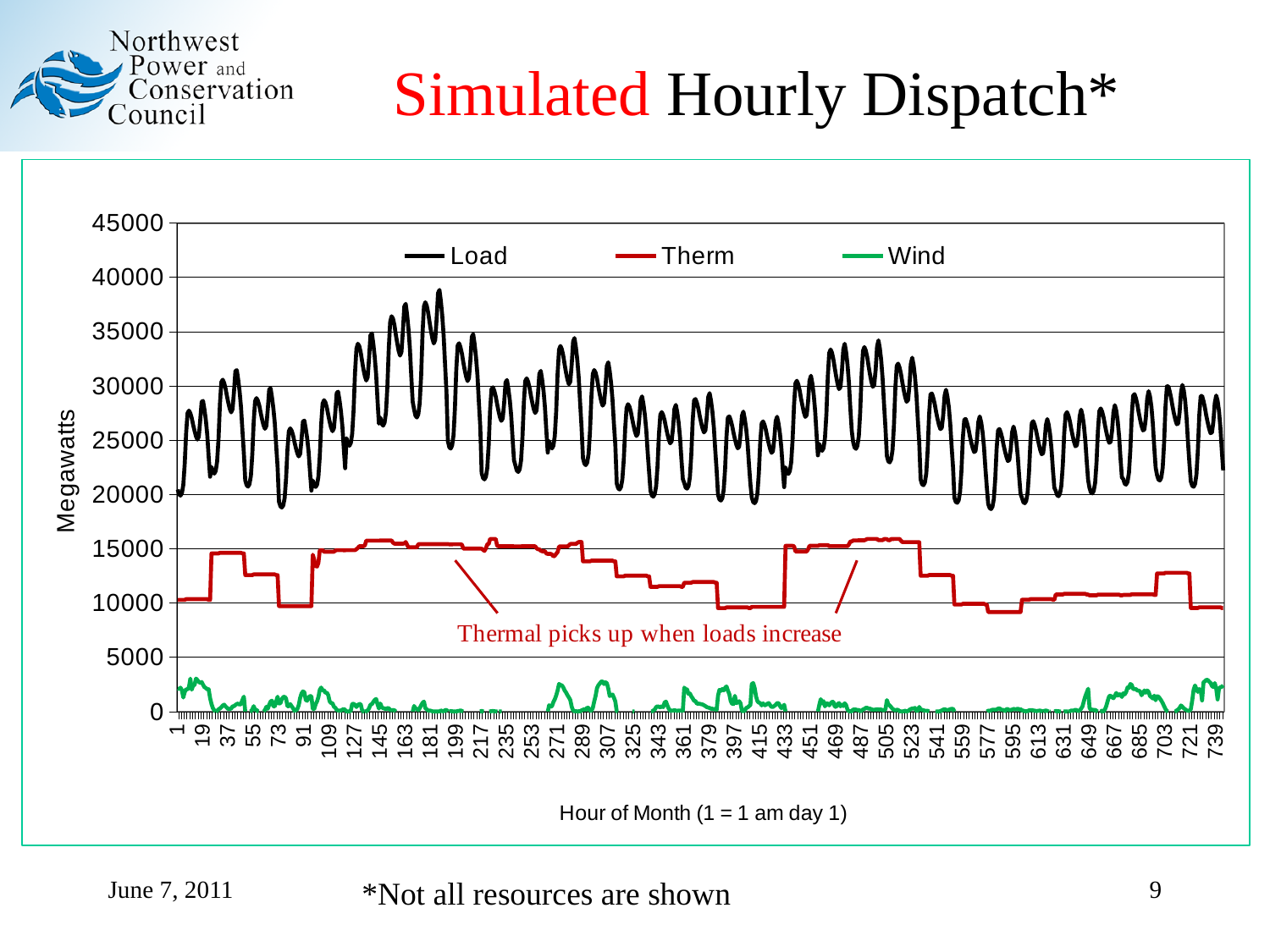
Which series has the lowest values throughout the chart? Wind Which series is larger at hour 181, Load or Therm? Load Is the lowest value of the Load series greater or less than 15000? greater What is the title of the chart on the slide? Simulated Hourly Dispatch* What is the label of the vertical axis? Megawatts Is the highest value of the Therm series greater or less than 20000? less Is the peak value of the Load series greater or less than 35000? greater Which series has the highest values throughout the chart? Load How many series does the legend list? 3 What kind of chart is shown on the slide? line chart Which series is larger at hour 505, Therm or Wind? Therm